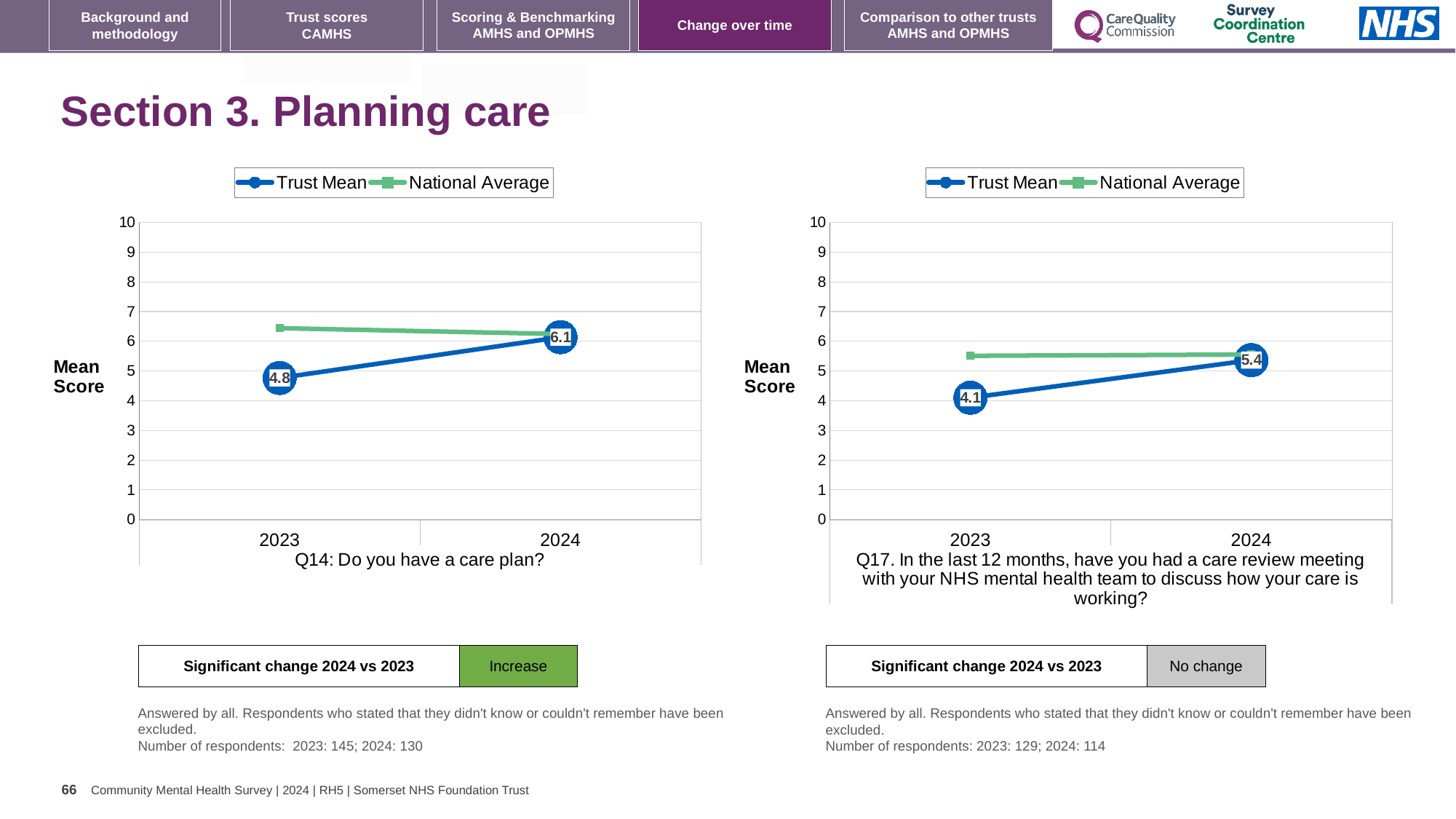
In the Q14 care plan chart, is the National Average for 2023 greater or less than 6? greater In the Q14 care plan chart, does the Trust Mean rise or fall from 2023 to 2024? rise What type of chart is the Q17 care review meeting chart? line chart In the Q14 care plan chart, what is the Trust Mean score for 2023? 4.8 In the Q17 care review meeting chart, is the National Average for 2023 greater or less than 5? greater In the Q17 care review meeting chart, what is the Trust Mean score for 2024? 5.4 In the Q14 care plan chart, what is the Trust Mean score for 2024? 6.1 In the Q17 care review meeting chart, what is the Trust Mean score for 2023? 4.1 In the Q17 care review meeting chart, by how much did the Trust Mean change from 2023 to 2024? 1.3 In the Q14 care plan chart, by how much did the Trust Mean increase from 2023 to 2024? 1.3 How many series does the legend of the Q14 care plan chart list? 2 In the Q17 care review meeting chart, which is larger in 2023: the Trust Mean or the National Average? National Average